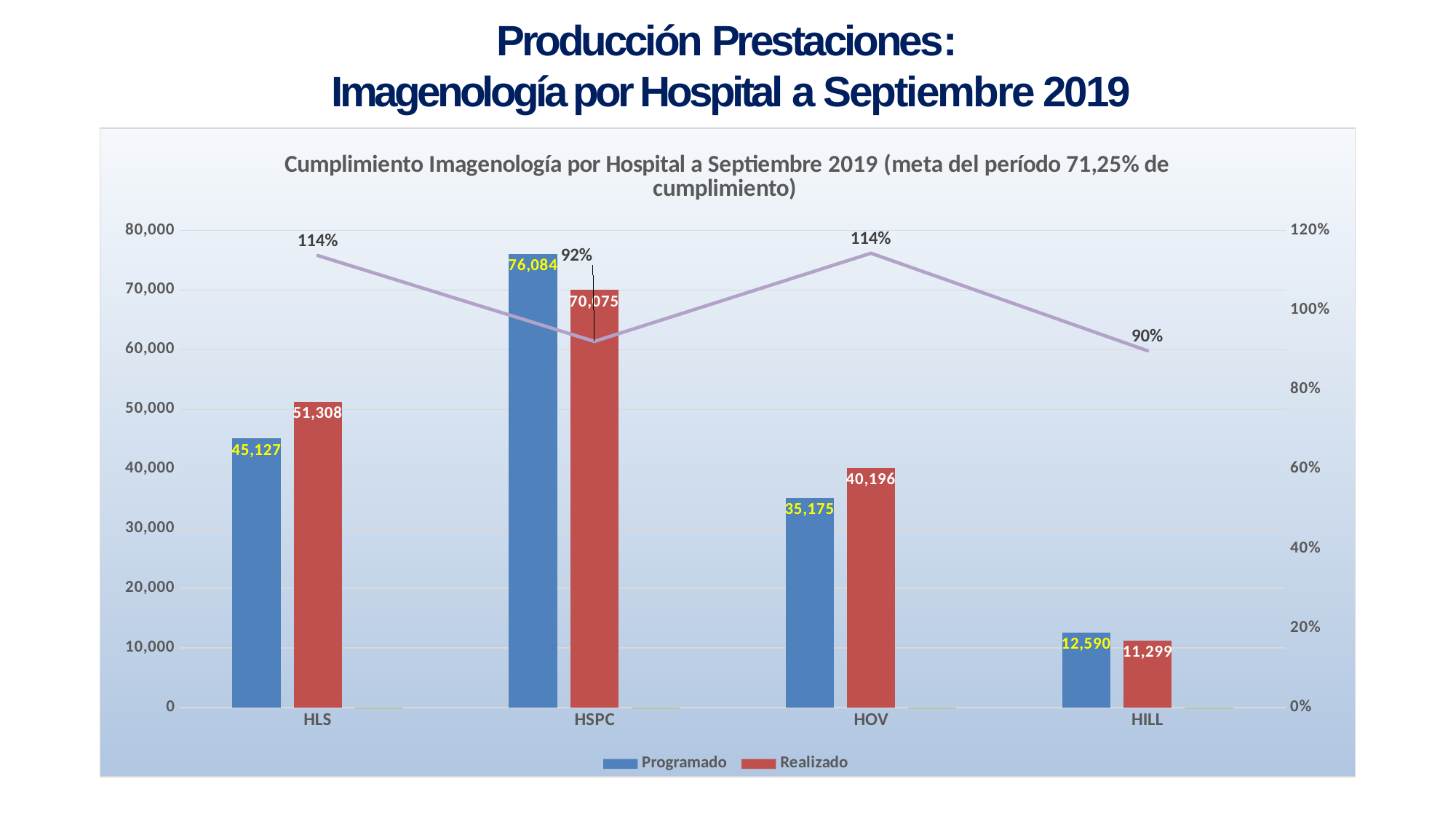
What is the Programado value for HLS? 45,127 For HILL, which is larger: Programado or Realizado? Programado What is the difference between the Realizado and Programado values for HLS? 6,181 How many hospitals are shown on the x axis? 4 Which hospital has the highest Programado value? HSPC What kind of chart is shown on the slide? combination bar and line chart Which hospital has the lowest Realizado value? HILL What compliance percentage is shown for HILL? 90% What is the Realizado value for HSPC? 70,075 How many series does the legend list? 2 What is the Programado value for HILL? 12,590 What is the Realizado value for HOV? 40,196